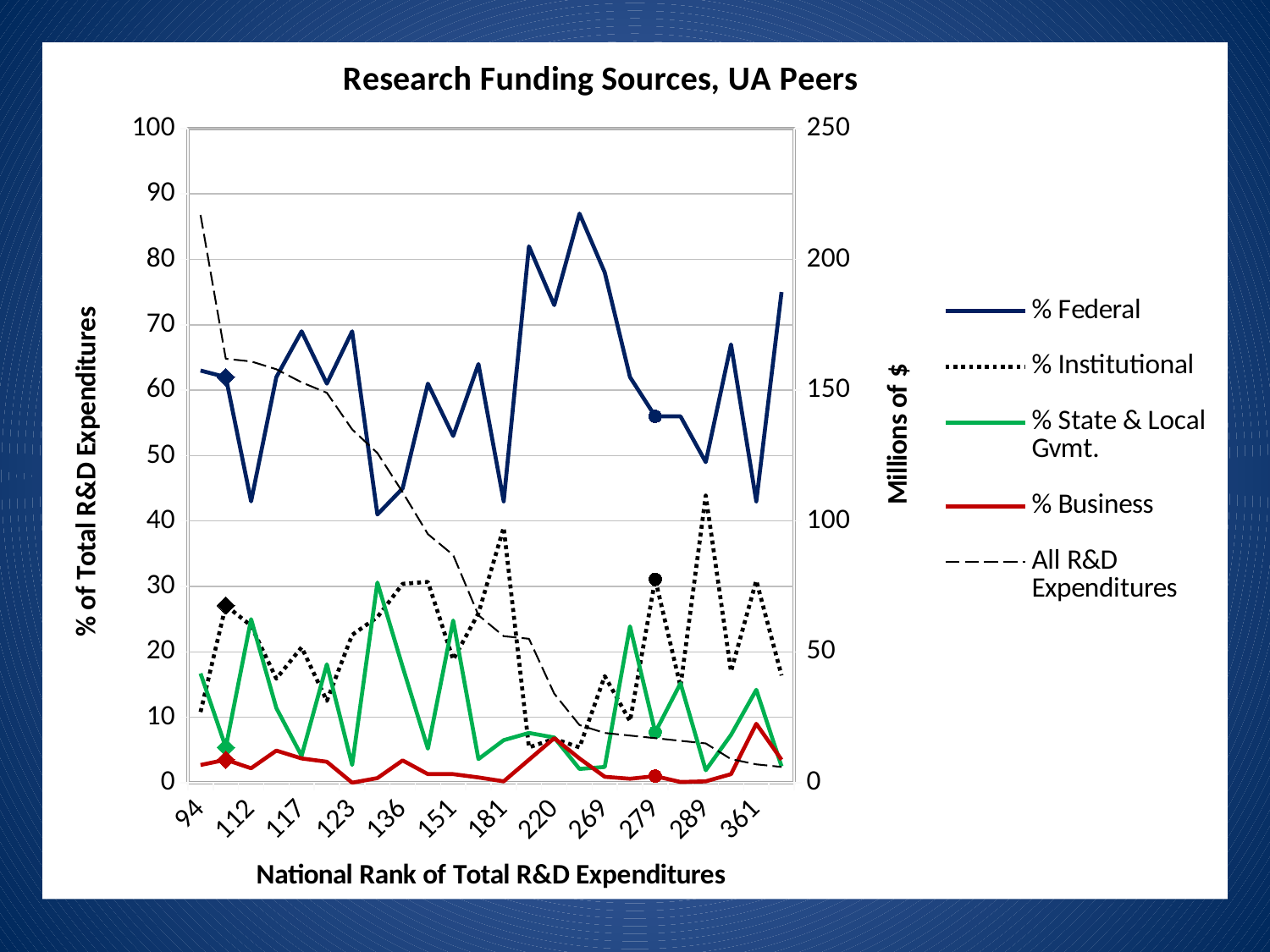
What is the title of the chart? Research Funding Sources, UA Peers Is the value of % Federal at national rank 112 greater or less than 50? less What is the title of the right-hand vertical axis? Millions of $ At national rank 279, which is larger: % Institutional or % State & Local Gvmt.? % Institutional Is the value of % Institutional at national rank 279 greater or less than 20? greater Is the value of % Federal at national rank 94 greater or less than 50? greater What kind of chart is shown on the slide? line chart At national rank 94, which is larger: % Federal or % Institutional? % Federal Do the values of All R&D Expenditures generally rise or fall as national rank increases along the x axis? fall How many series does the legend list? 5